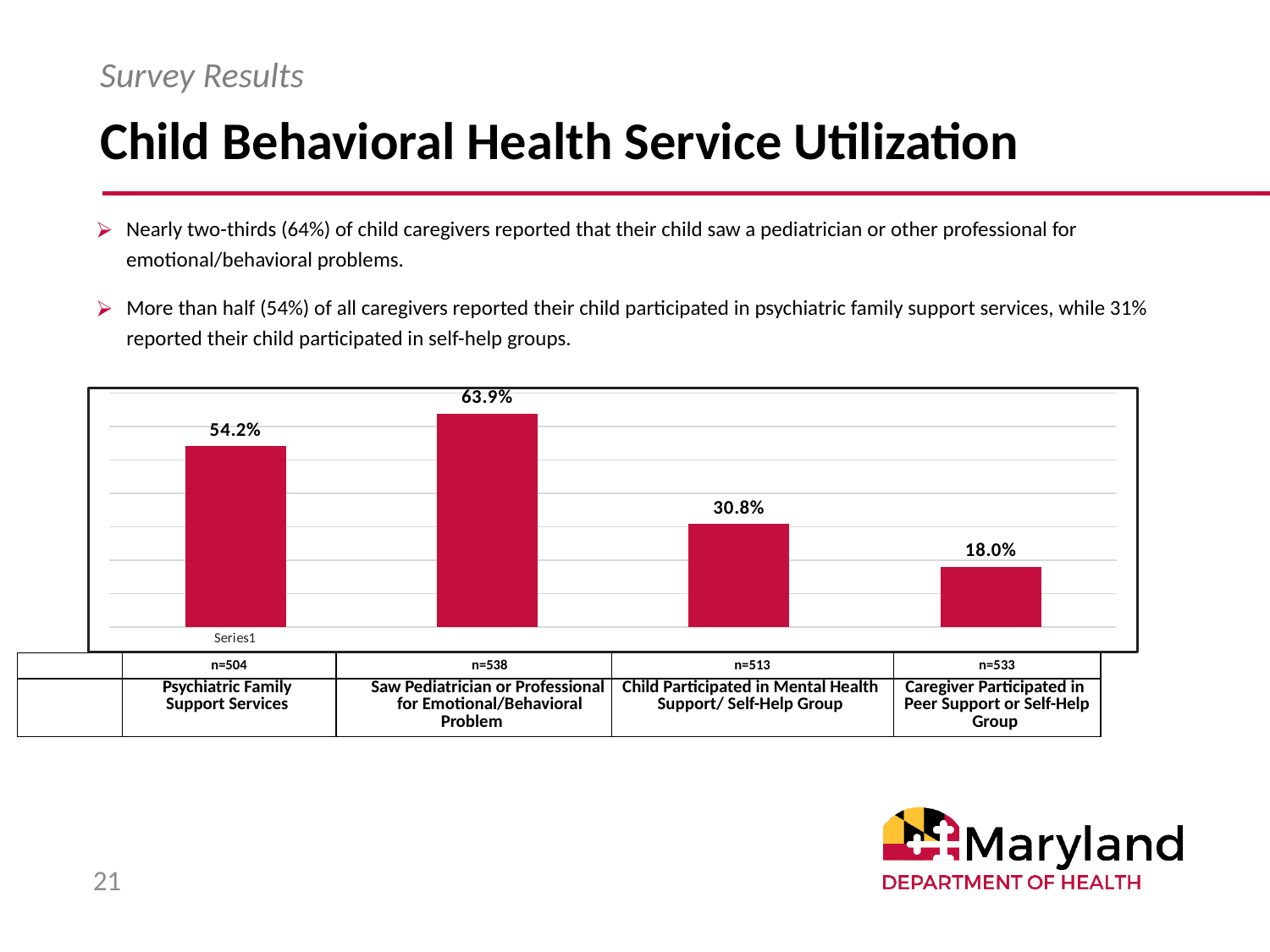
What percentage is shown for Saw Pediatrician or Professional for Emotional/Behavioral Problem? 63.9% What is the difference between the values for Child Participated in Mental Health Support/ Self-Help Group and Caregiver Participated in Peer Support or Self-Help Group? 12.8% How many categories are plotted in the chart? 4 What percentage is shown for Caregiver Participated in Peer Support or Self-Help Group? 18.0% What kind of chart is shown on the slide? Bar chart What percentage is shown for Child Participated in Mental Health Support/ Self-Help Group? 30.8% What percentage is shown for Psychiatric Family Support Services? 54.2% Which is larger: the value for Psychiatric Family Support Services or the value for Child Participated in Mental Health Support/ Self-Help Group? Psychiatric Family Support Services What is the difference between the values for Saw Pediatrician or Professional for Emotional/Behavioral Problem and Psychiatric Family Support Services? 9.7% Which category has the highest value in the chart? Saw Pediatrician or Professional for Emotional/Behavioral Problem What is the sample size (n) shown for the Saw Pediatrician or Professional for Emotional/Behavioral Problem category? n=538 Which category has the lowest value in the chart? Caregiver Participated in Peer Support or Self-Help Group